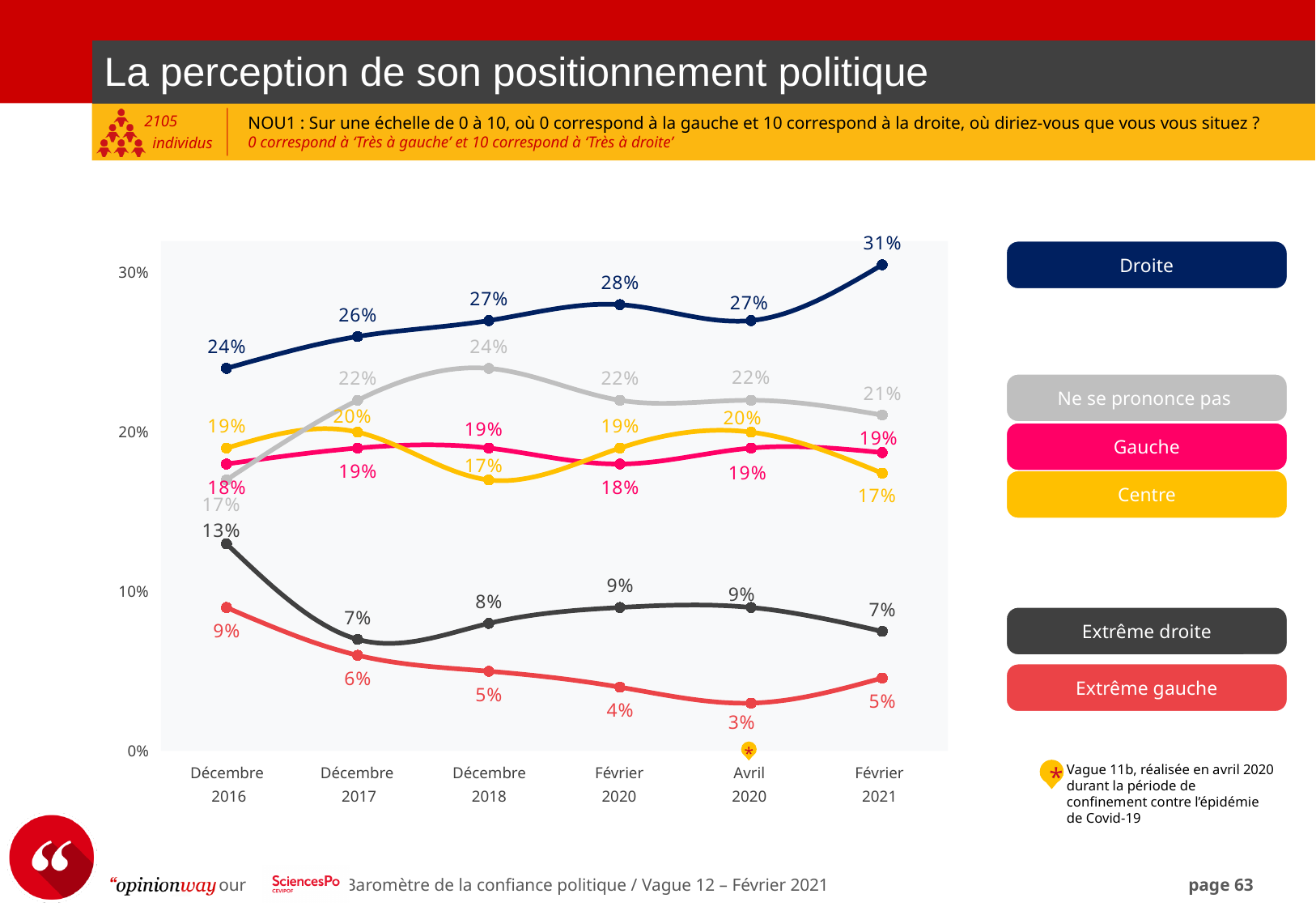
How many series does the legend list? 6 What is the value for Extrême droite in Décembre 2016? 13% In which period does Extrême gauche reach its lowest value? Avril 2020 Does the Extrême droite series rise or fall between Décembre 2016 and Décembre 2017? fall In which period does Droite reach its highest value? Février 2021 What is the value for Droite in Février 2021? 31% How many time periods are shown on the x axis? 6 What is the value for Extrême gauche in Avril 2020? 3% Which is larger in Décembre 2018: the value for Gauche or the value for Centre? Gauche What is the difference between the Droite value in Février 2021 and in Décembre 2016? 7% What is the value for Ne se prononce pas in Décembre 2018? 24% What type of chart is shown on the slide? line chart